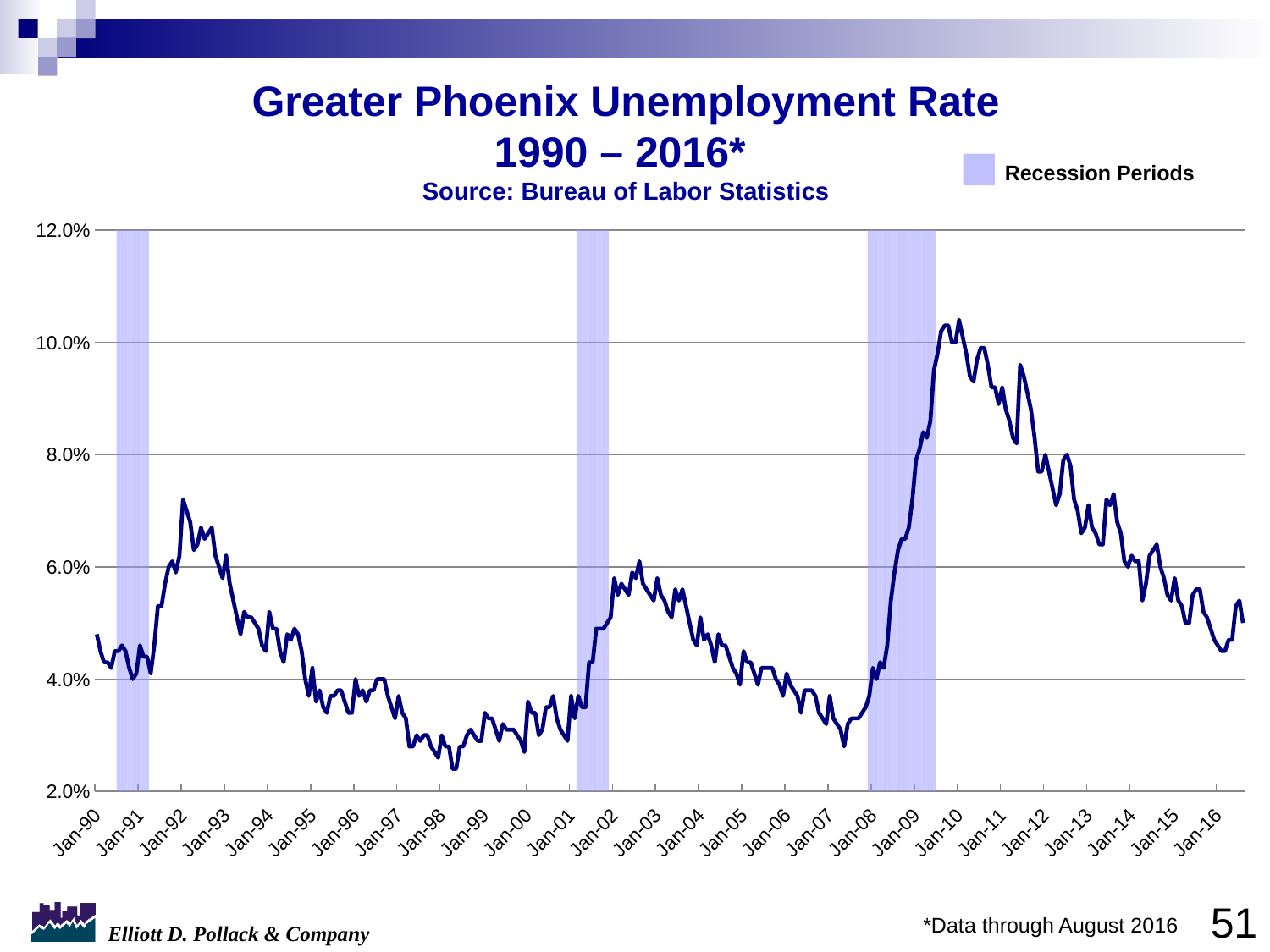
What do the shaded vertical bands on the chart represent? Recession Periods In which year does the unemployment rate reach its highest point on the chart? 2010 Is the highest point of the unemployment rate, reached around 2010, greater or less than 8.0%? greater Which peak is higher: the one around 1992 or the one around 2010? 2010 What kind of chart is shown on the slide? Line chart Does the unemployment rate rise or fall between Jan-07 and Jan-10? rise How many recession periods are shaded on the chart? 3 Does the unemployment rate rise or fall between Jan-10 and Jan-16? fall What is the title of the chart? Greater Phoenix Unemployment Rate 1990 – 2016* What is the highest value shown on the vertical axis? 12.0% Is the unemployment rate at Jan-98 greater or less than 4.0%? less Is the unemployment rate at Jan-07 greater or less than 4.0%? less